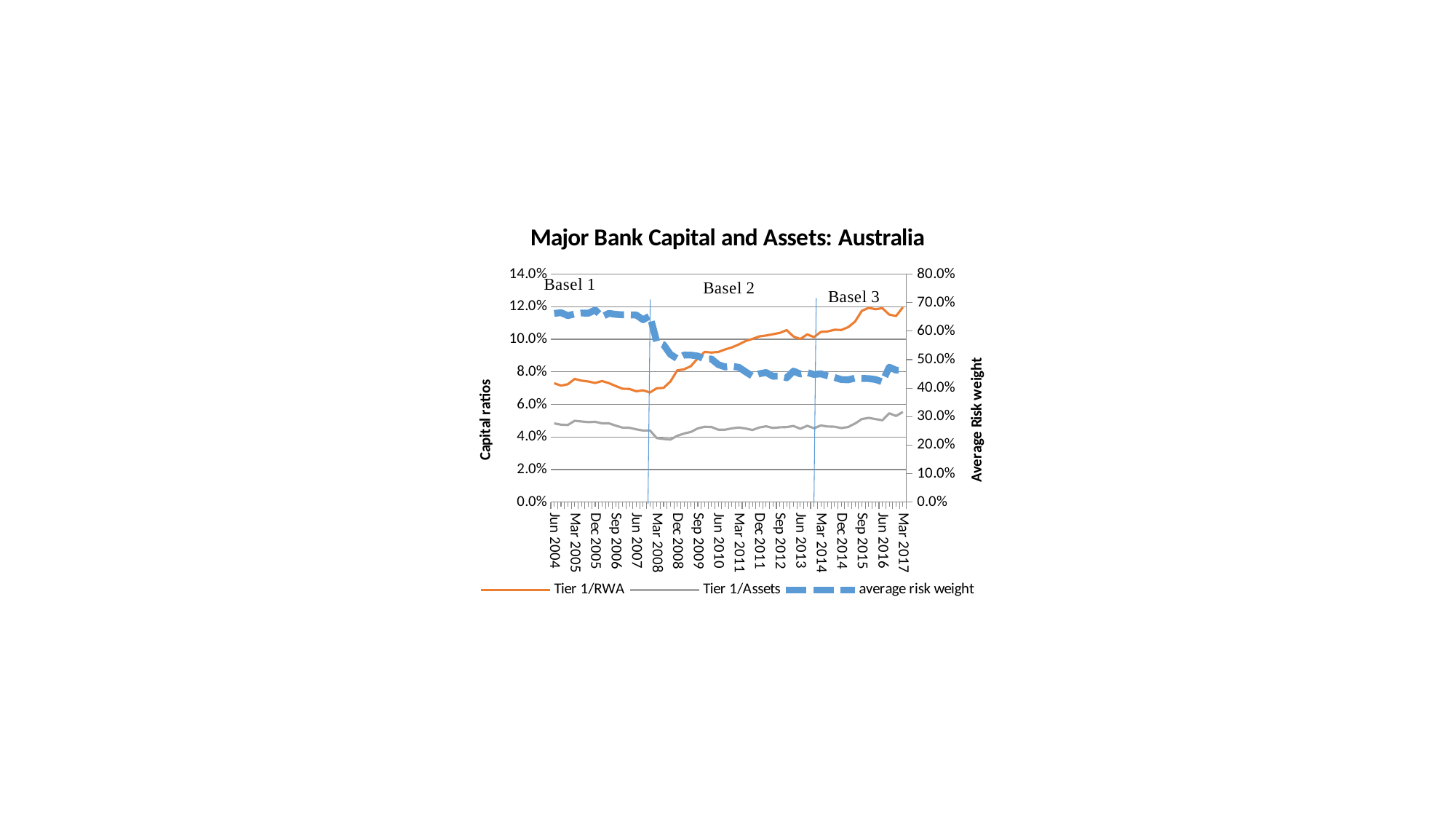
Is the value for Tier 1/RWA at Mar 2017 greater or less than 10.0%? greater Is the value for Tier 1/Assets at Mar 2017 greater or less than 4.0%? greater How many series does the legend list? 3 What type of chart is shown on the slide? line chart Is the value for Tier 1/RWA at Jun 2004 greater or less than 8.0%? less What is the title of the chart? Major Bank Capital and Assets: Australia At Mar 2017, which is larger on the capital ratios axis: Tier 1/RWA or Tier 1/Assets? Tier 1/RWA Does the Tier 1/RWA series generally rise or fall from Jun 2004 to Mar 2017? rise What is the label of the right-hand vertical axis? Average Risk weight Does the average risk weight series generally rise or fall from Jun 2004 to Mar 2017? fall